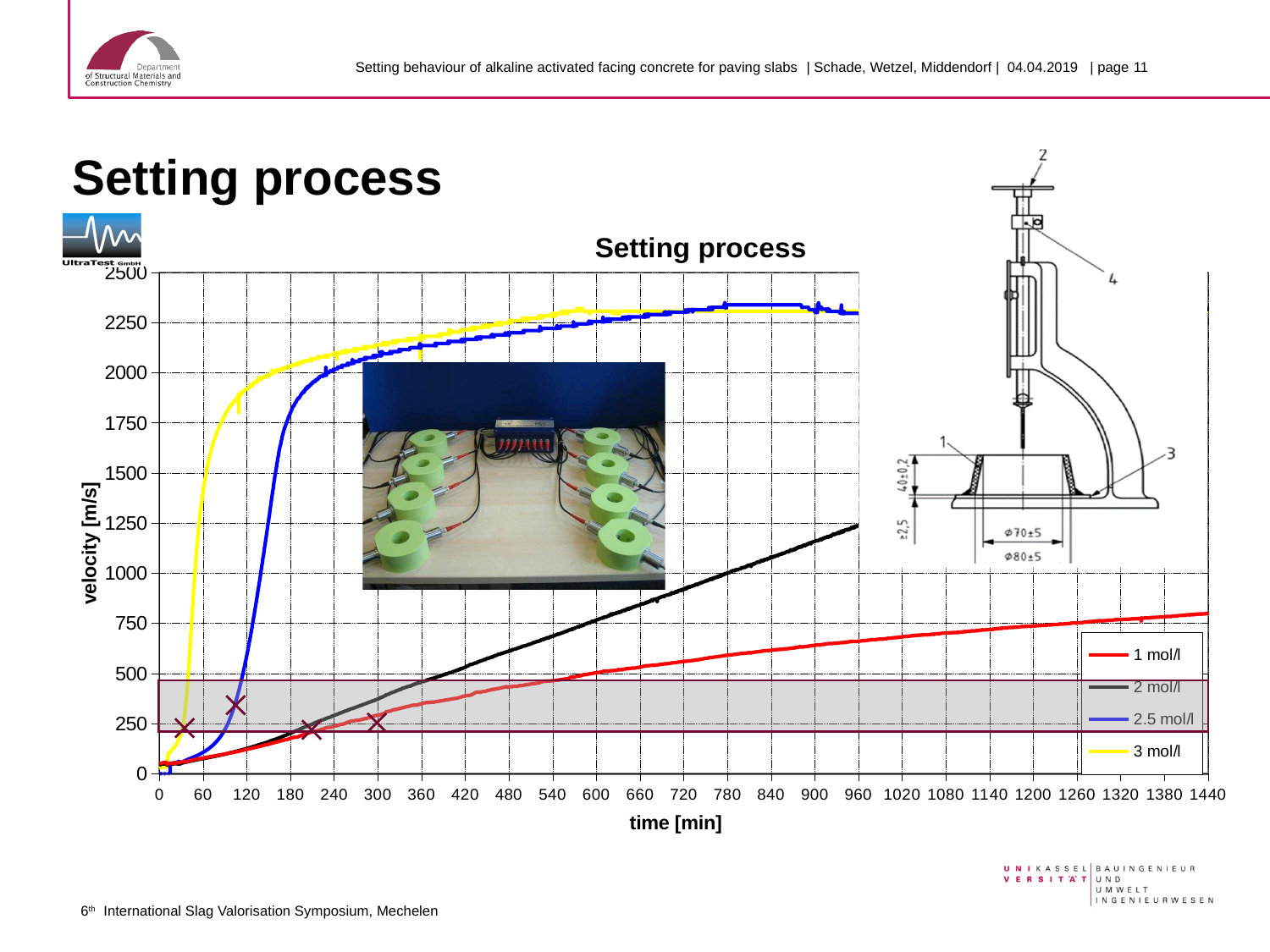
At 240 min, which series has the higher velocity, 2.5 mol/l or 2 mol/l? 2.5 mol/l What is the label of the y axis of the chart? velocity [m/s] What kind of chart is shown on the slide? line chart Is the value for 2.5 mol/l at 60 min greater or less than 500? less Which series has the highest velocity at 60 min? 3 mol/l What is the title of the chart? Setting process Does the velocity of the 1 mol/l series rise or fall as time increases? rise How many series does the legend of the chart list? 4 Is the value for 3 mol/l at 120 min greater or less than 1750? greater Is the value for 2 mol/l at 600 min greater or less than 500? greater Which series has the lowest velocity at 900 min? 1 mol/l